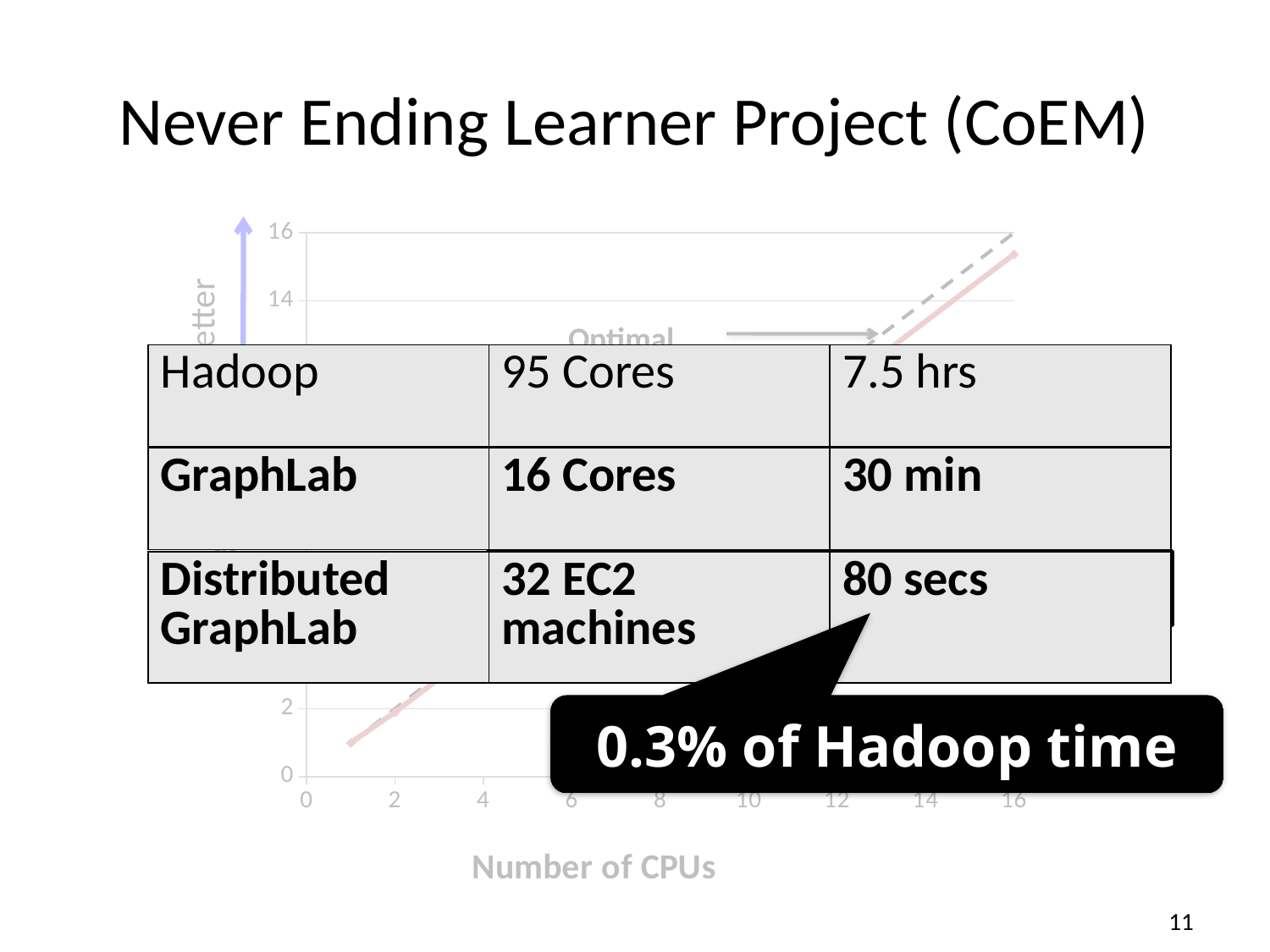
What is the label of the x axis of the chart? Number of CPUs What kind of chart is shown behind the table on the slide? line chart What is the highest tick value shown on the y axis of the chart? 16 What is the highest tick value shown on the x axis of the chart? 16 Does the red line in the chart rise or fall as the number of CPUs increases? rise Is the value of the red line at 2 CPUs greater or less than 4? less Is the value of the red line at 16 CPUs greater or less than 14? greater At 16 CPUs, which line is higher in the chart, the dashed Optimal line or the red line? the dashed Optimal line